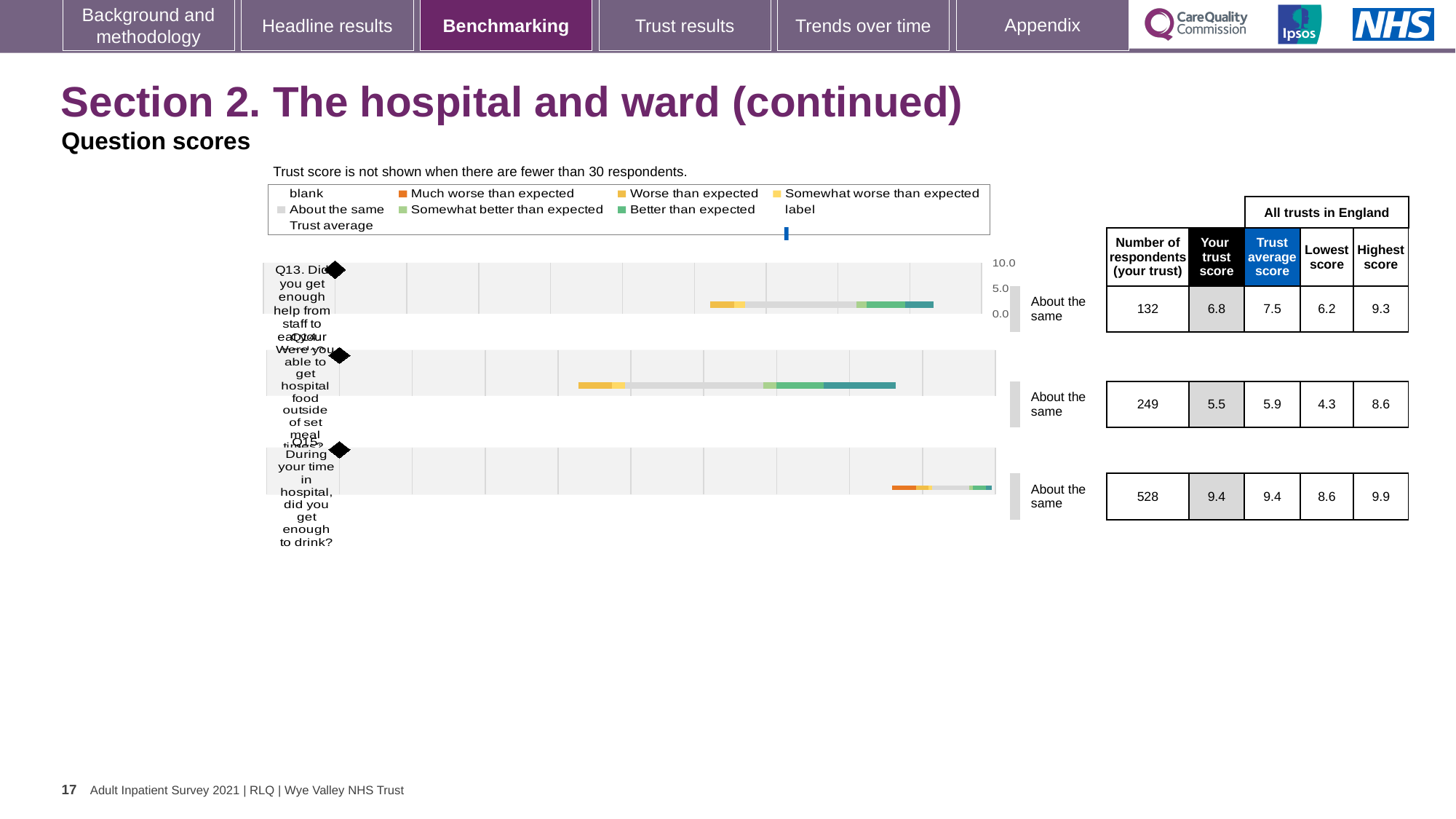
What is the trust score for Q14 (Were you able to get hospital food outside of set meal times?)? 5.5 What is the difference between the trust average score and the trust score for Q13? 0.7 What benchmark category is shown for Q14? About the same Which question has the lowest trust score? Q14 Which question has the highest number of respondents? Q15 For Q13, which is larger: the trust score or the trust average score? Trust average score What is the number of respondents for Q13 (Did you get enough help from staff to eat your meals?)? 132 How many questions are plotted in the chart? 3 What is the trust average score for Q15 (did you get enough to drink?)? 9.4 What is the lowest score across all trusts in England for Q14? 4.3 Which colour in the legend represents 'Much worse than expected'? Orange What kind of chart is used to show the question scores on this slide? bar chart